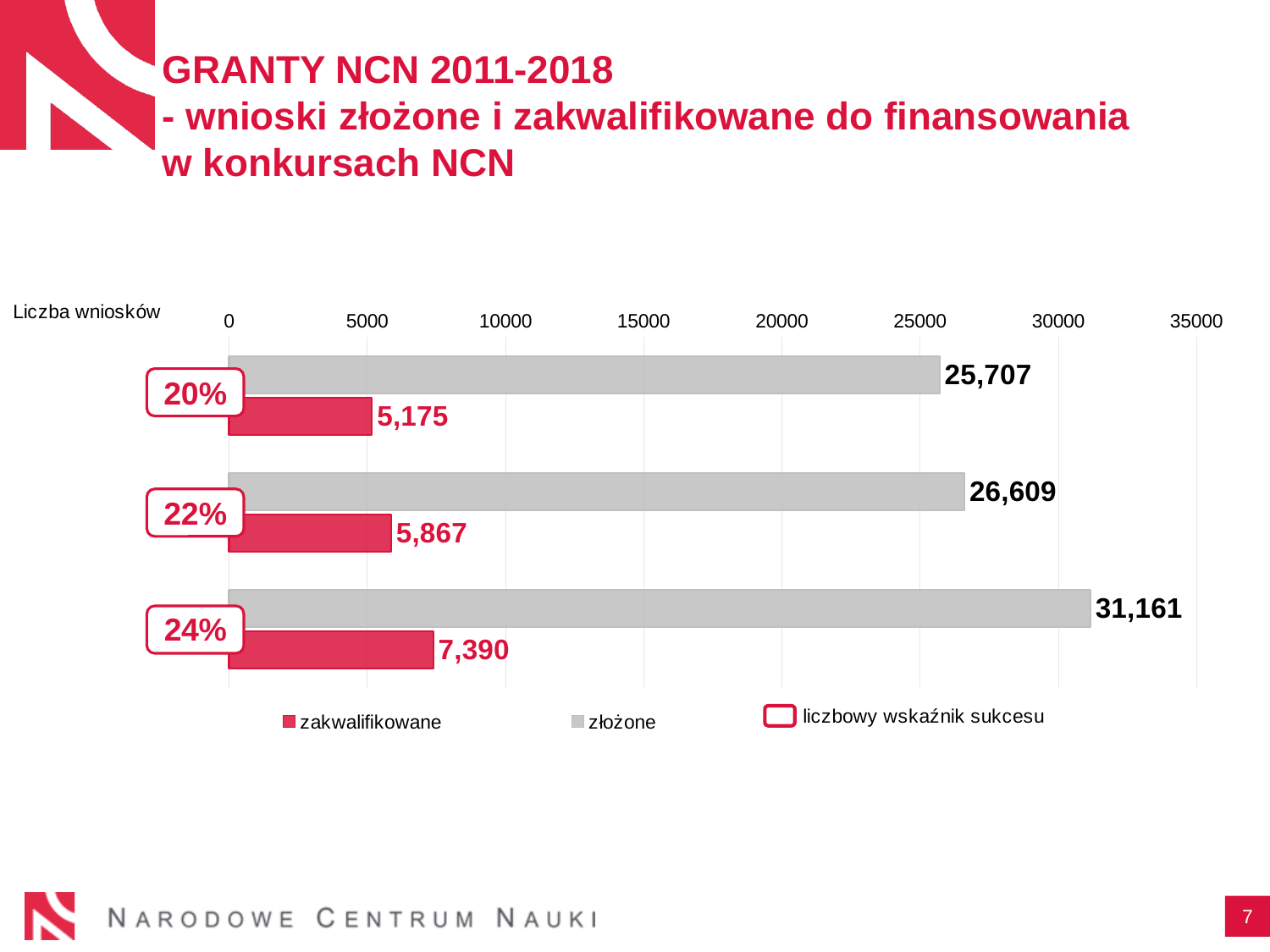
What is the 'złożone' value for the top group of bars (labelled 20%)? 25,707 What is the 'złożone' value for the bottom group of bars (labelled 24%)? 31,161 What type of chart is shown on the slide? bar chart Which is larger: the 'złożone' value of the middle group (22%) or the 'złożone' value of the top group (20%)? the middle group (26,609) Which group of bars has the highest 'złożone' value? the bottom group (24%) What is the difference between the 'złożone' and 'zakwalifikowane' values in the top group (20%)? 20,532 What is the 'zakwalifikowane' value for the middle group of bars (labelled 22%)? 5,867 How many entries does the chart legend list? 3 Which group of bars has the lowest 'zakwalifikowane' value? the top group (20%) What is the difference between the 'zakwalifikowane' values of the bottom group (24%) and the top group (20%)? 2,215 What does the red outlined box in the legend represent? liczbowy wskaźnik sukcesu How many groups of bars are plotted in the chart? 3